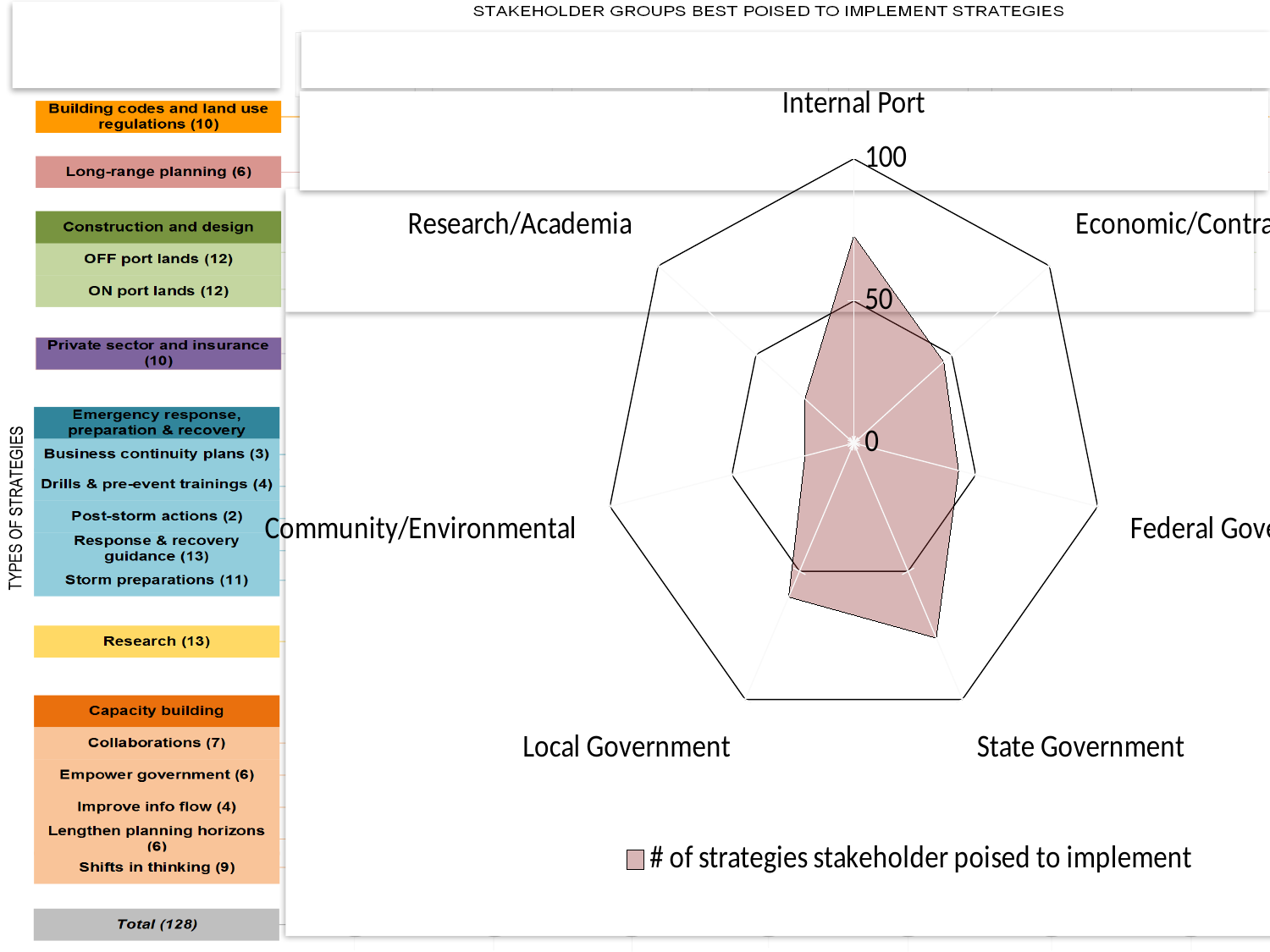
What is the title of the chart? STAKEHOLDER GROUPS BEST POISED TO IMPLEMENT STRATEGIES Is the value for Internal Port greater or less than 50? greater Is the value for State Government greater or less than 50? greater What is the series name shown in the chart legend? # of strategies stakeholder poised to implement How many series does the chart legend list? 1 Is the value for Community/Environmental greater or less than 50? less Which has a larger value, State Government or Community/Environmental? State Government What kind of chart is shown on the slide? Radar chart Which has a larger value, Internal Port or Research/Academia? Internal Port How many stakeholder group axes does the radar chart have? 7